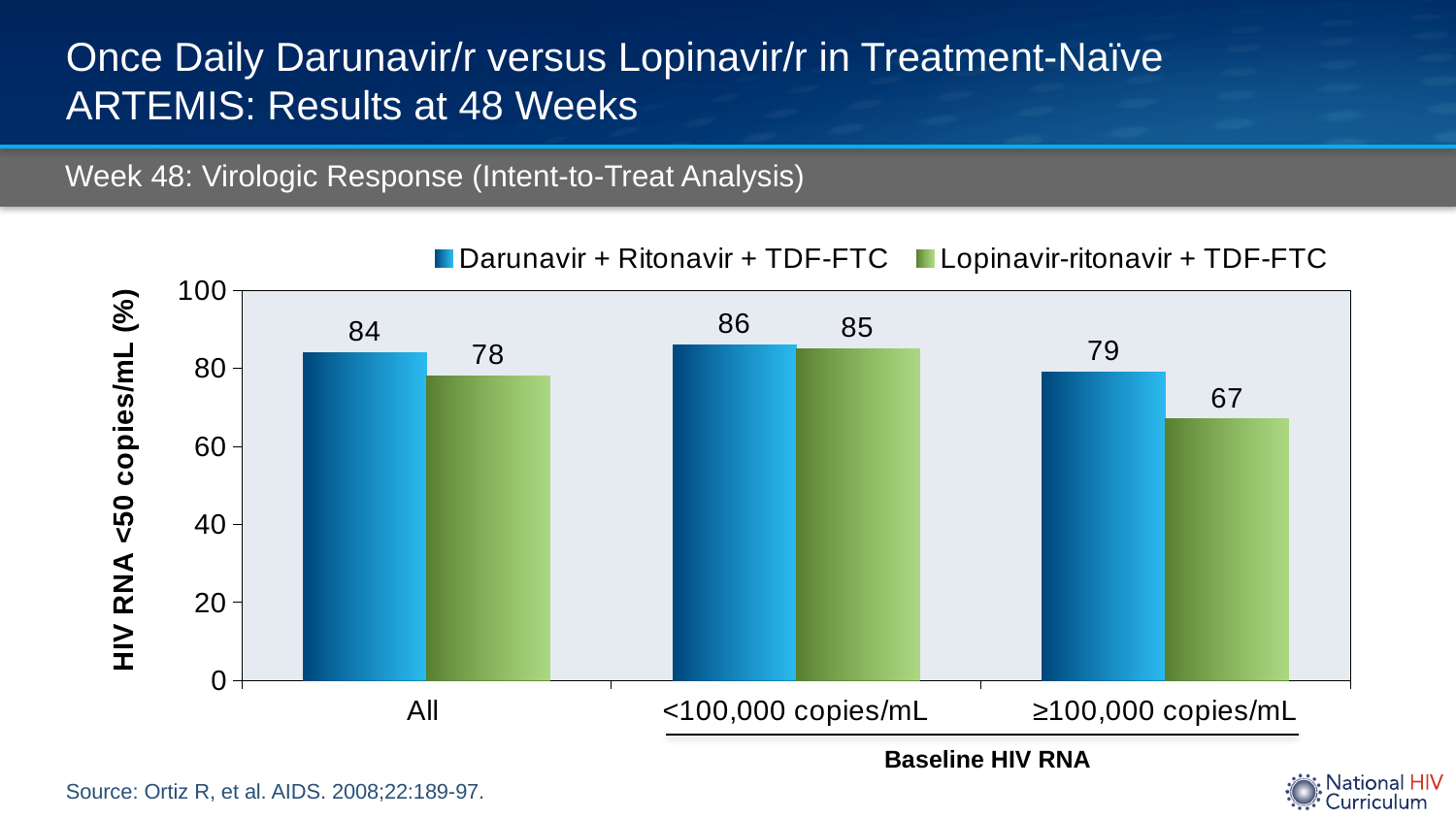
What is the value for Darunavir + Ritonavir + TDF-FTC in the All category? 84 What is the value for Lopinavir-ritonavir + TDF-FTC in the ≥100,000 copies/mL category? 67 Which category has the lowest value for Lopinavir-ritonavir + TDF-FTC? ≥100,000 copies/mL What is the difference between the Darunavir + Ritonavir + TDF-FTC and Lopinavir-ritonavir + TDF-FTC values in the All category? 6 What is the value for Lopinavir-ritonavir + TDF-FTC in the <100,000 copies/mL category? 85 How many series does the legend list? 2 How many categories are shown on the x axis? 3 What is the label of the y axis? HIV RNA <50 copies/mL (%) In the All category, which series has the larger value? Darunavir + Ritonavir + TDF-FTC What is the difference between the Darunavir + Ritonavir + TDF-FTC and Lopinavir-ritonavir + TDF-FTC values in the ≥100,000 copies/mL category? 12 What kind of chart is shown on the slide? Bar chart Which category has the highest value for Darunavir + Ritonavir + TDF-FTC? <100,000 copies/mL